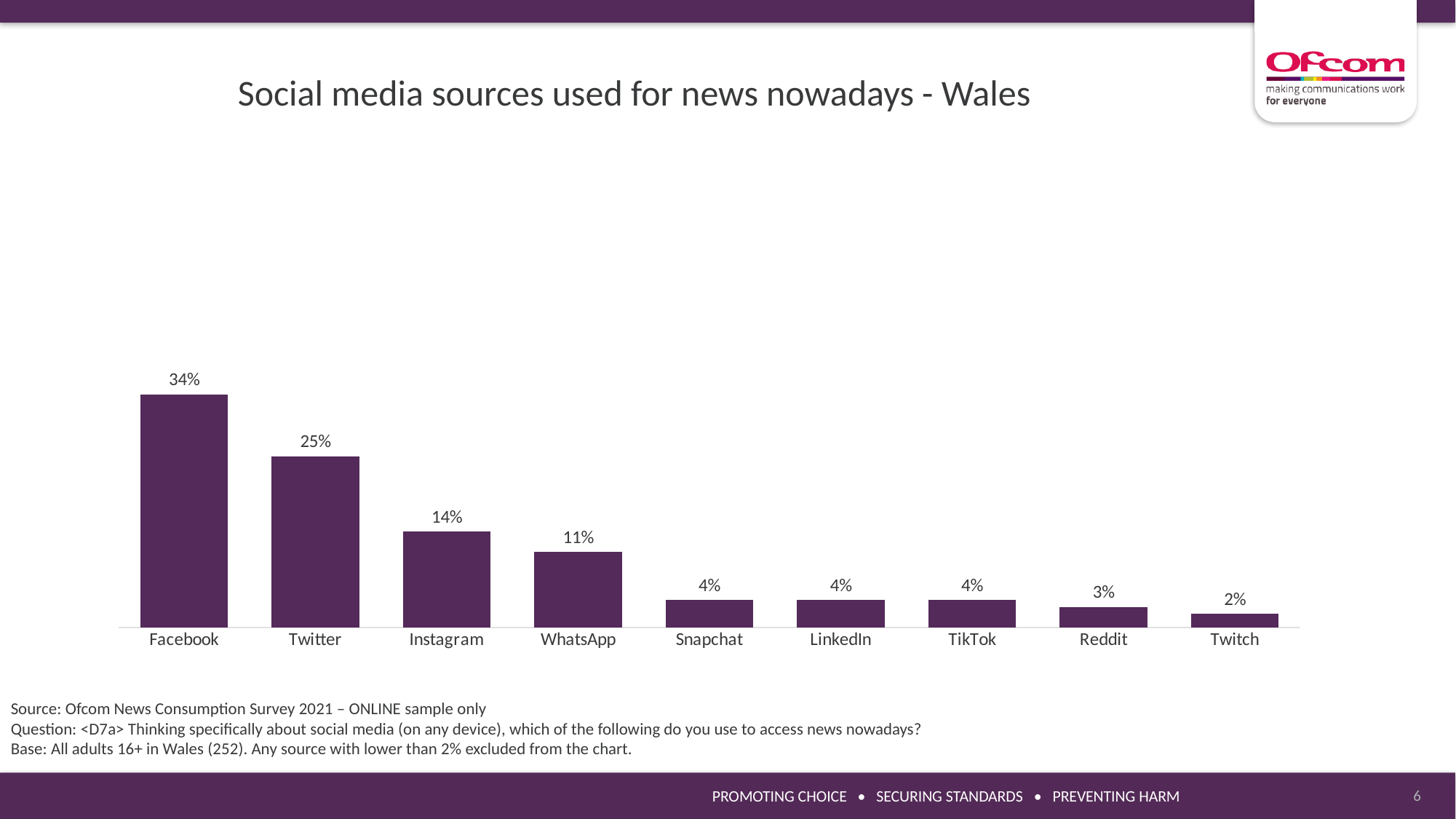
What is the difference between the values for Facebook and Twitter? 9% What percentage of respondents use Facebook as a social media source for news? 34% What kind of chart is shown on the slide? Bar chart Do the values rise or fall moving from left to right across the chart? Fall Which has a larger value, Instagram or WhatsApp? Instagram What percentage is shown for WhatsApp? 11% Which social media source has the lowest value? Twitch What is the value shown for Twitter? 25% What is the difference between the values for Instagram and WhatsApp? 3% What is the value for Reddit? 3% Which social media source has the highest value? Facebook How many social media sources are shown in the chart? 9